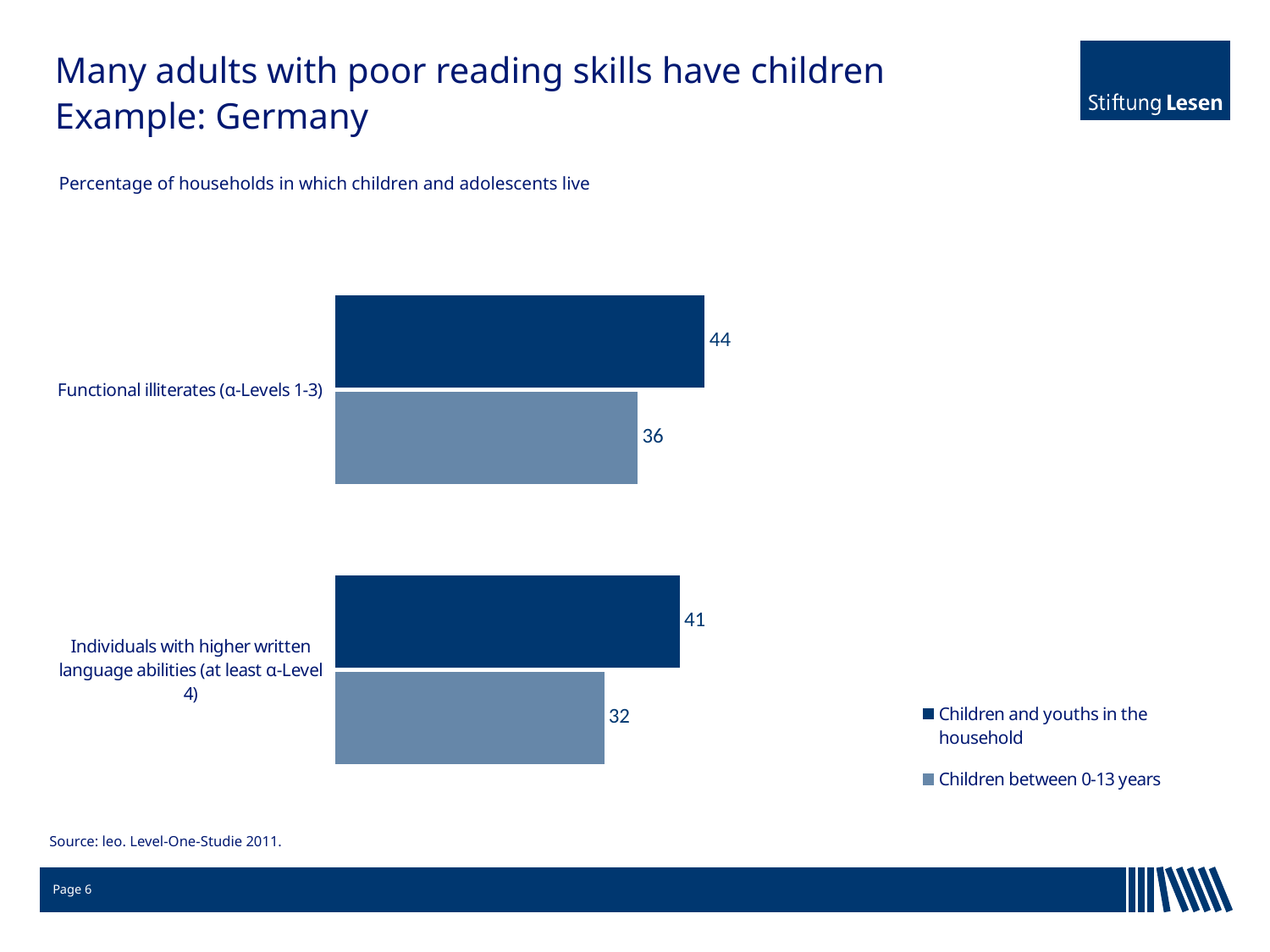
What is the difference between the 'Children and youths in the household' and 'Children between 0-13 years' values for Functional illiterates (α-Levels 1-3)? 8 What is the value for 'Children and youths in the household' for Functional illiterates (α-Levels 1-3)? 44 How many categories are shown on the chart? 2 Which category has the highest value for 'Children and youths in the household'? Functional illiterates (α-Levels 1-3) What is the value for 'Children between 0-13 years' for Functional illiterates (α-Levels 1-3)? 36 How many series does the legend list? 2 What kind of chart is shown on the slide? Bar chart What is the value for 'Children between 0-13 years' for Individuals with higher written language abilities (at least α-Level 4)? 32 What is the value for 'Children and youths in the household' for Individuals with higher written language abilities (at least α-Level 4)? 41 Which is larger: the 'Children between 0-13 years' value for Functional illiterates or for Individuals with higher written language abilities? Functional illiterates (α-Levels 1-3) Which category has the lowest value for 'Children between 0-13 years'? Individuals with higher written language abilities (at least α-Level 4) What is the difference between the 'Children and youths in the household' values for Functional illiterates and Individuals with higher written language abilities? 3